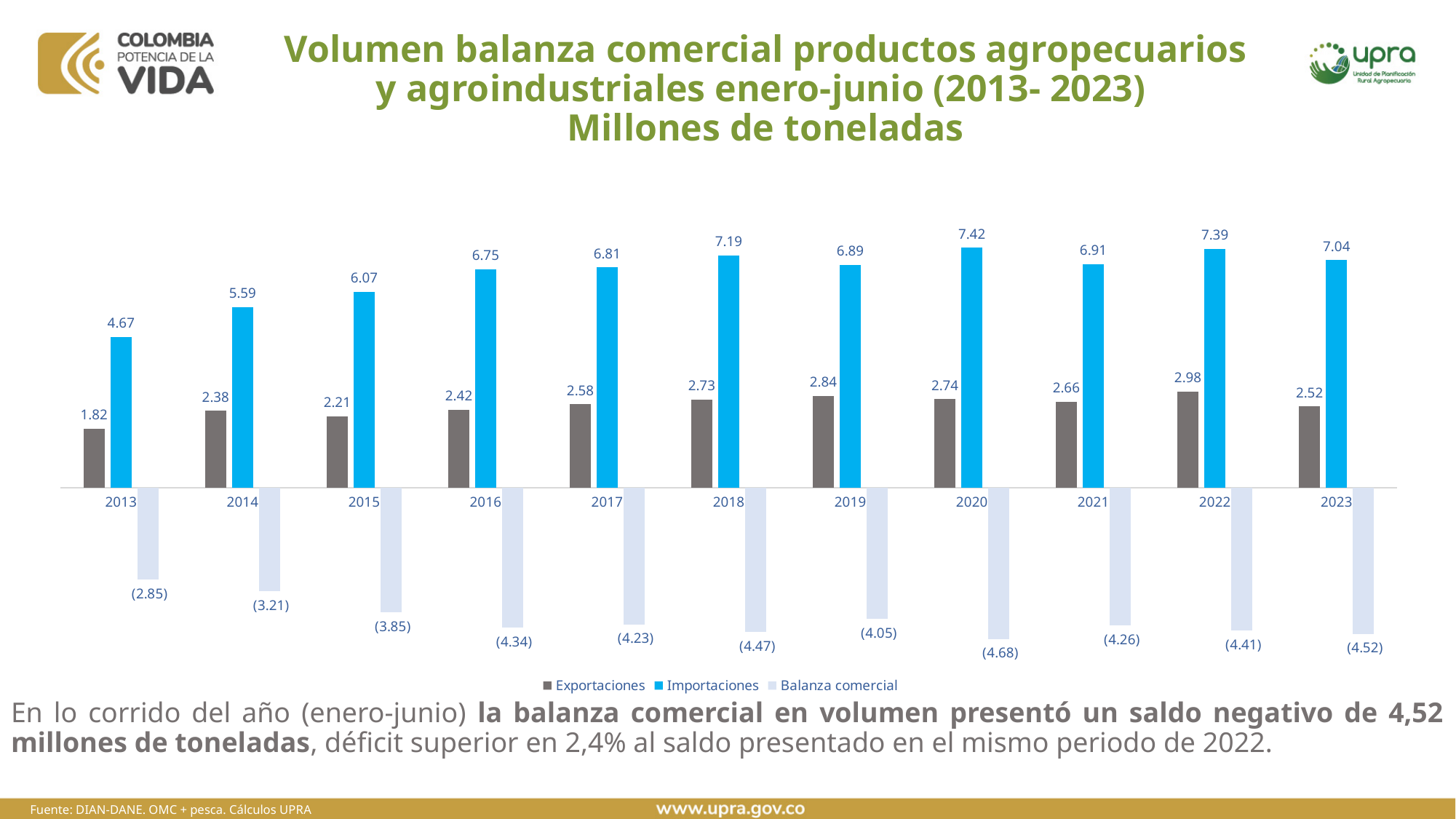
What is the value of Importaciones for 2020? 7.42 Do the Importaciones values rise or fall from 2013 to 2016? Rise What kind of chart is shown on the slide? Bar chart How many years are shown on the x axis? 11 What is the value of Balanza comercial for 2023? (4.52) In which year is the Exportaciones value lowest? 2013 In which year is the Exportaciones value highest? 2022 In which year is the Importaciones value highest? 2020 What is the difference between Importaciones and Exportaciones in 2023? 4.52 What is the value of Exportaciones for 2013? 1.82 How many series does the legend list? 3 Which is larger, Importaciones in 2018 or Importaciones in 2019? Importaciones in 2018